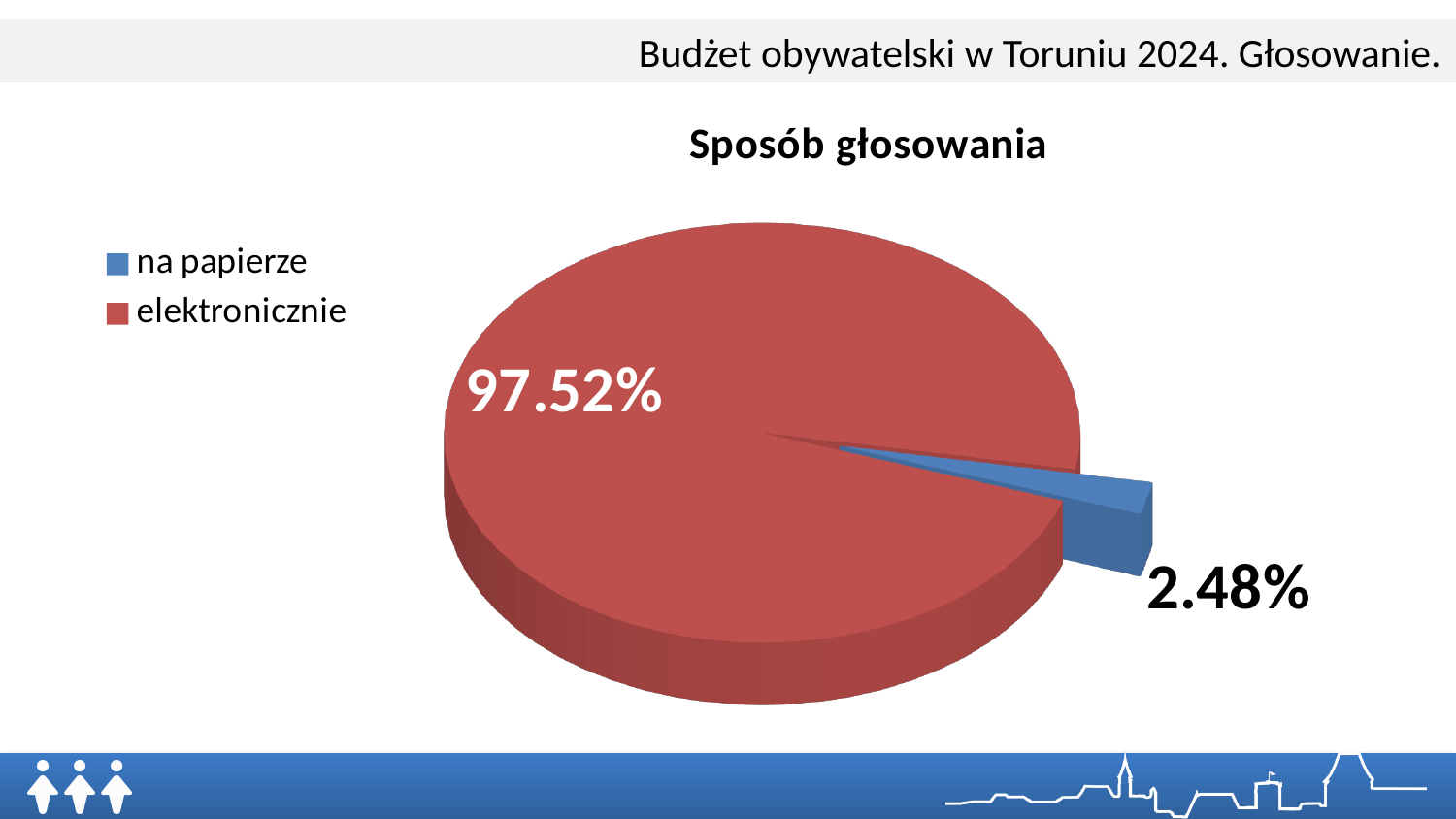
How many entries does the legend list? 2 Which is larger, the share for 'na papierze' or the share for 'elektronicznie'? elektronicznie What share of the pie does 'na papierze' represent? 2.48% What is the title of the chart? Sposób głosowania Which category has the largest slice of the pie? elektronicznie Which category has the smallest slice of the pie? na papierze What is the difference in percentage points between 'elektronicznie' and 'na papierze'? 95.04 What colour is the slice for 'na papierze'? blue What type of chart is shown on the slide? pie chart What share of the pie does 'elektronicznie' represent? 97.52% How many categories does the pie chart show? 2